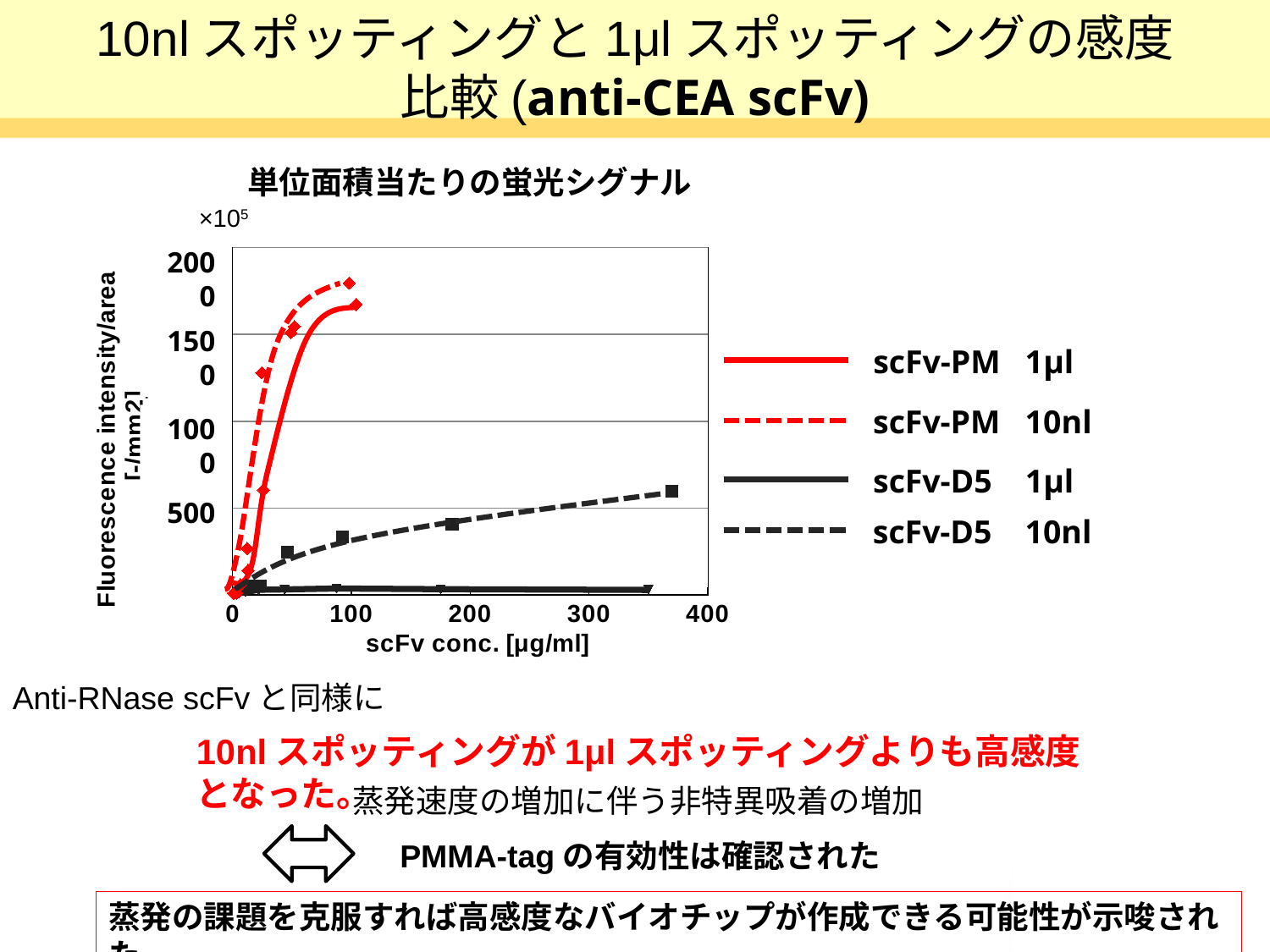
Is the value for scFv-PM 10nl at 100 µg/ml greater or less than 1500? greater How many series does the chart legend list? 4 Which series is drawn as a solid red line? scFv-PM 1µl Does the scFv-D5 10nl series rise or fall as scFv concentration increases? rise At 100 µg/ml, which series has the higher fluorescence intensity: scFv-PM 10nl or scFv-PM 1µl? scFv-PM 10nl Is the value for scFv-D5 1µl at 200 µg/ml greater or less than 500? less Which series stays lowest across the concentration range? scFv-D5 1µl Which series reaches the highest fluorescence intensity on the chart? scFv-PM 10nl Is the value for scFv-D5 10nl at about 370 µg/ml greater or less than 500? greater What kind of chart is shown on the slide? line chart What is the x-axis title of the chart? scFv conc. [µg/ml] At 200 µg/ml, which series has the higher fluorescence intensity: scFv-D5 10nl or scFv-D5 1µl? scFv-D5 10nl